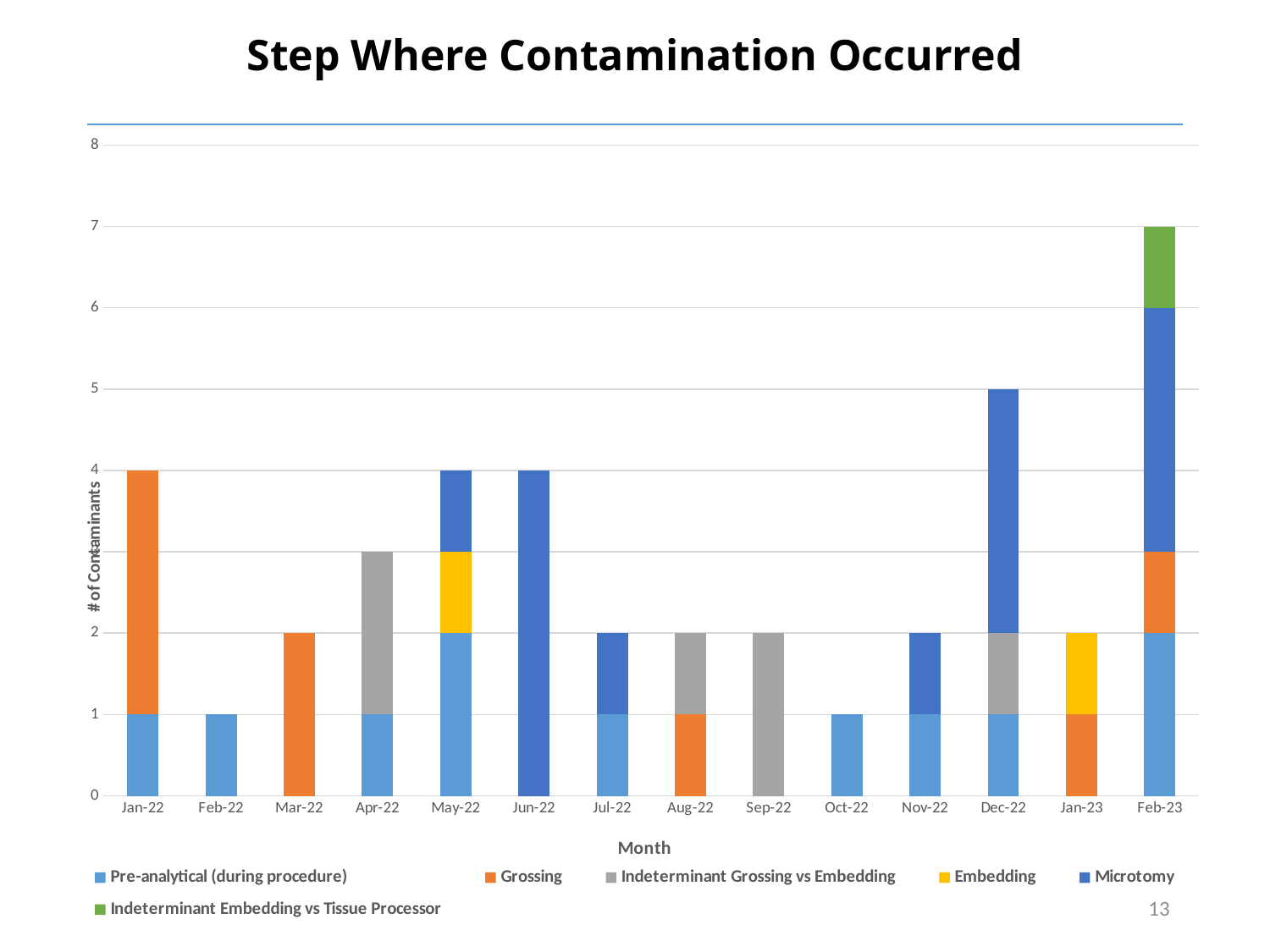
What colour represents the Embedding series in the legend? Yellow What is the total number of contaminants for Feb-23? 7 What is the total number of contaminants for Dec-22? 5 How many months are shown on the x axis? 14 What is the difference between the total contaminants in Feb-23 and Dec-22? 2 Which month has a higher total number of contaminants, Dec-22 or Jan-22? Dec-22 How many Microtomy contaminants are shown for Jun-22? 4 Is the total number of contaminants for Feb-23 greater or less than 6? greater What kind of chart is shown on the slide? Stacked bar chart How many series does the legend list? 6 Which month has the highest total number of contaminants? Feb-23 How many Grossing contaminants are shown for Jan-22? 3